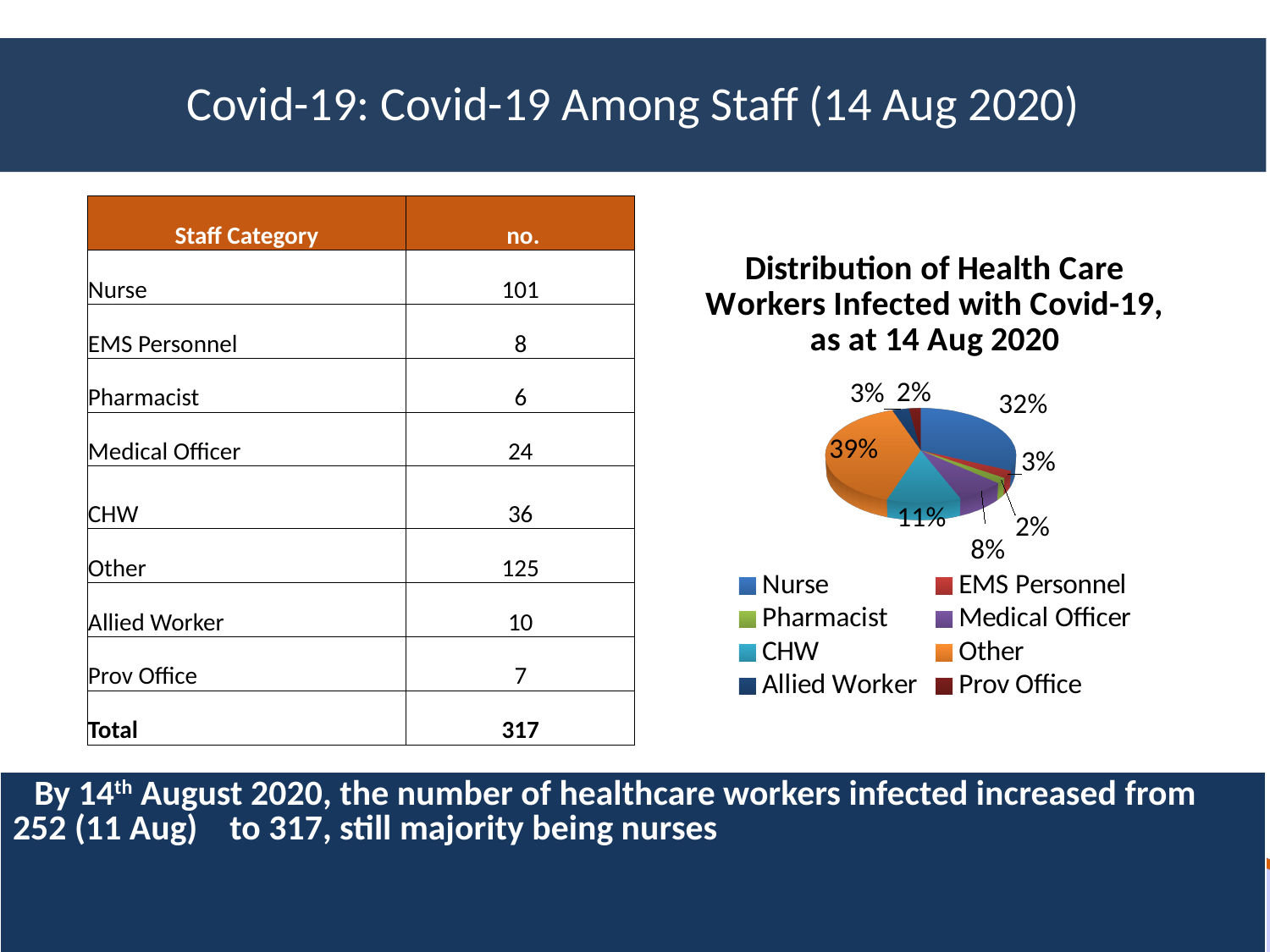
What is the difference in percentage points between the Other slice and the Nurse slice? 7 percentage points How many categories does the legend of the pie chart list? 8 Which colour represents the Other category in the pie chart? Orange What is the title of the pie chart? Distribution of Health Care Workers Infected with Covid-19, as at 14 Aug 2020 Which slice is larger in the pie chart, Nurse or CHW? Nurse What share of the pie chart does the Medical Officer category represent? 8% What share of the pie chart does the CHW category represent? 11% What share of the pie chart does the Nurse category represent? 32% Which slice is larger in the pie chart, Medical Officer or CHW? CHW What kind of chart is shown on the slide? Pie chart Which category has the largest slice in the pie chart? Other